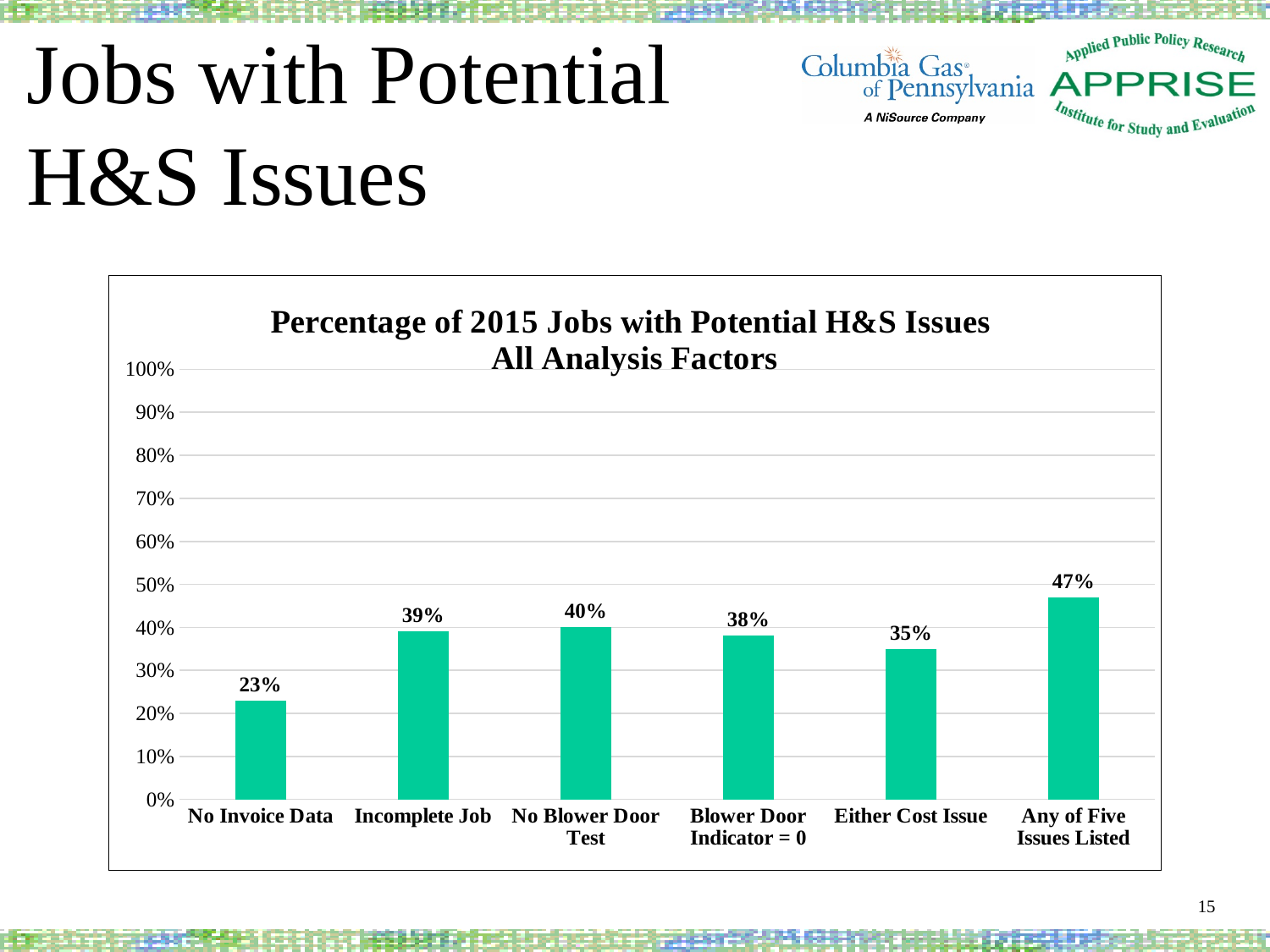
Which category has the lowest percentage? No Invoice Data Is the value for Blower Door Indicator = 0 greater or less than 50%? less Which category has the highest percentage? Any of Five Issues Listed What is the value for Any of Five Issues Listed? 47% How many categories are shown on the x axis? 6 What kind of chart is shown on the slide? bar chart What percentage of 2015 jobs had No Invoice Data? 23% Which is larger, Incomplete Job or Either Cost Issue? Incomplete Job What is the value for Either Cost Issue? 35% What is the difference between No Blower Door Test and Either Cost Issue? 5% What is the difference between Any of Five Issues Listed and No Invoice Data? 24% What is the title of the chart? Percentage of 2015 Jobs with Potential H&S Issues All Analysis Factors